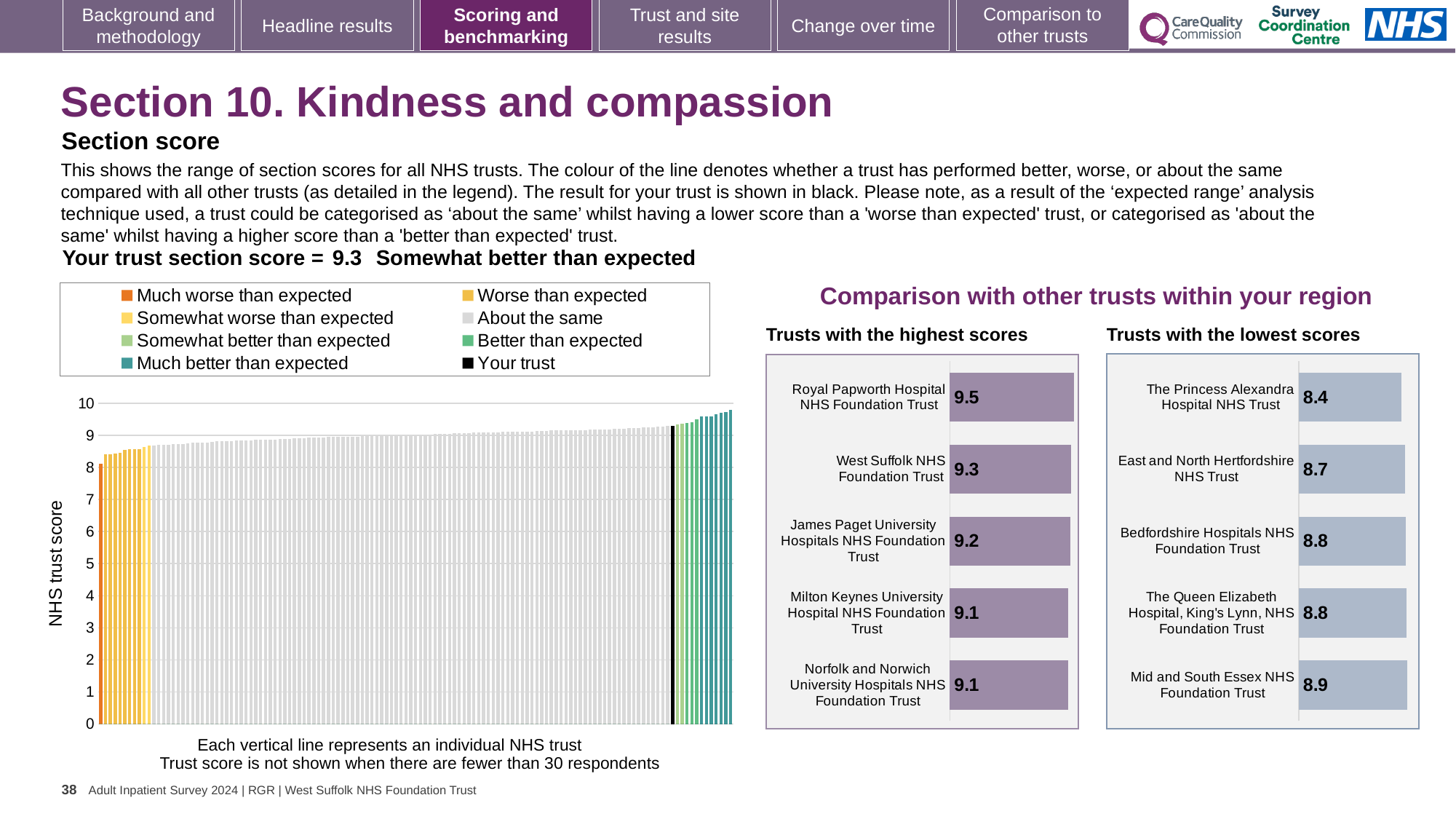
In the main NHS trust score chart, is the value for the black 'Your trust' bar greater or less than 9? greater In the 'Trusts with the highest scores' chart, what is the difference between the scores of Royal Papworth Hospital NHS Foundation Trust and West Suffolk NHS Foundation Trust? 0.2 What is the y-axis label of the main chart on the left of the slide? NHS trust score In the 'Trusts with the highest scores' chart, which has the larger score: James Paget University Hospitals NHS Foundation Trust or Milton Keynes University Hospital NHS Foundation Trust? James Paget University Hospitals NHS Foundation Trust In the 'Trusts with the highest scores' chart, which trust has the highest score? Royal Papworth Hospital NHS Foundation Trust In the 'Trusts with the lowest scores' chart, how much higher is the score of Mid and South Essex NHS Foundation Trust than that of The Princess Alexandra Hospital NHS Trust? 0.5 What kind of chart is the 'Trusts with the highest scores' chart? Bar chart In the 'Trusts with the lowest scores' chart, which trust has the lowest score? The Princess Alexandra Hospital NHS Trust How many trusts are shown in the 'Trusts with the lowest scores' chart? 5 In the 'Trusts with the lowest scores' chart, what is the score for The Princess Alexandra Hospital NHS Trust? 8.4 How many entries does the legend of the main NHS trust score chart list? 8 In the 'Trusts with the highest scores' chart, what is the score for Royal Papworth Hospital NHS Foundation Trust? 9.5